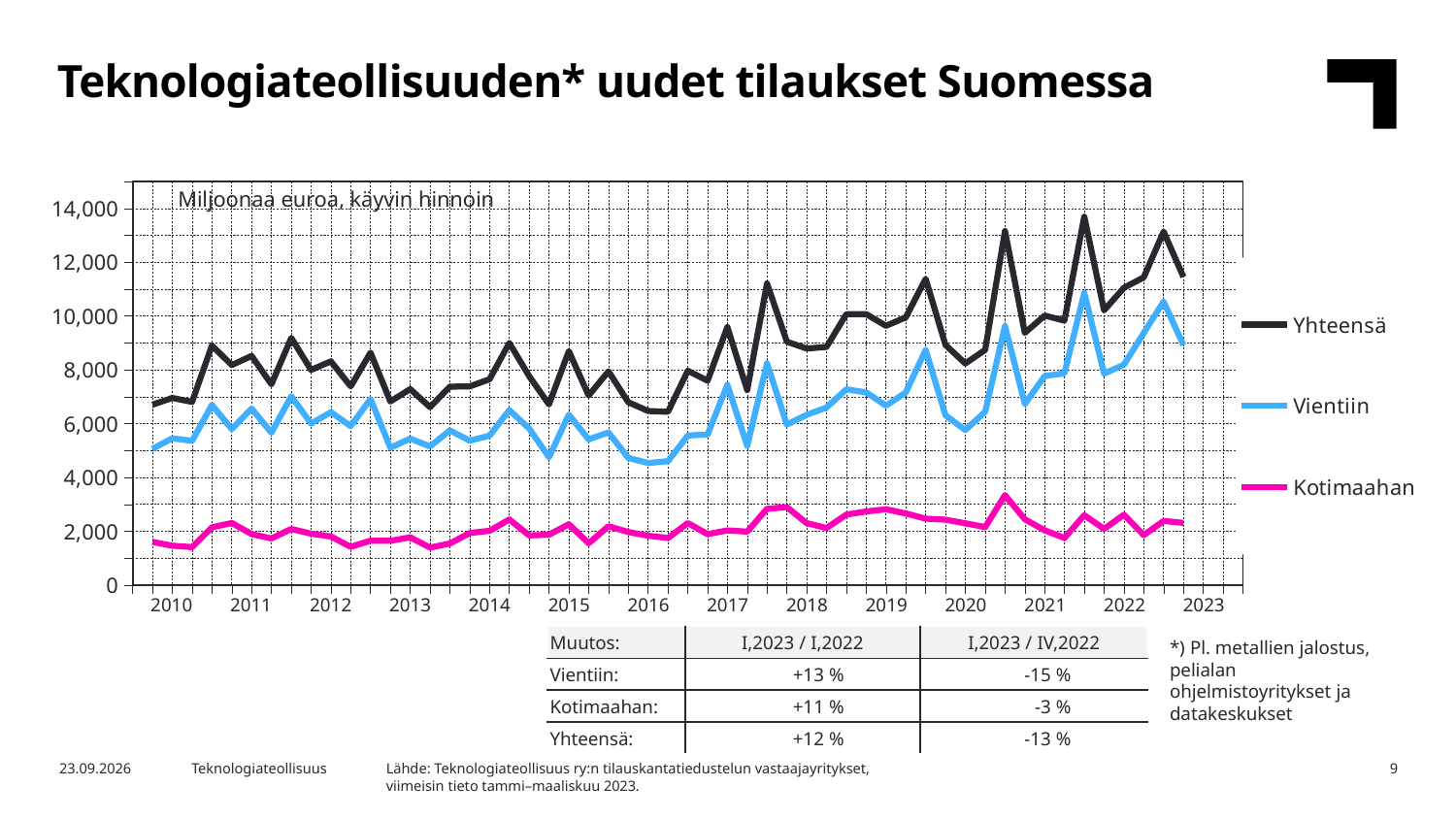
Which series has the lowest values throughout the chart? Kotimaahan Is the peak value of Yhteensä in 2021 greater or less than 12,000? greater How many year labels are shown on the x axis? 14 What unit is stated in the chart's subtitle? Miljoonaa euroa, käyvin hinnoin What are the three series named in the chart legend? Yhteensä, Vientiin, Kotimaahan Which series is larger in 2018, Vientiin or Kotimaahan? Vientiin Is the lowest value of Vientiin in 2016 greater or less than 6,000? less Which series has the highest values throughout the chart? Yhteensä Does the Yhteensä series overall rise or fall from 2010 to 2022? rise What kind of chart is shown on the slide? line chart Is the value for Kotimaahan at the start of 2010 greater or less than 4,000? less How many series does the chart legend list? 3